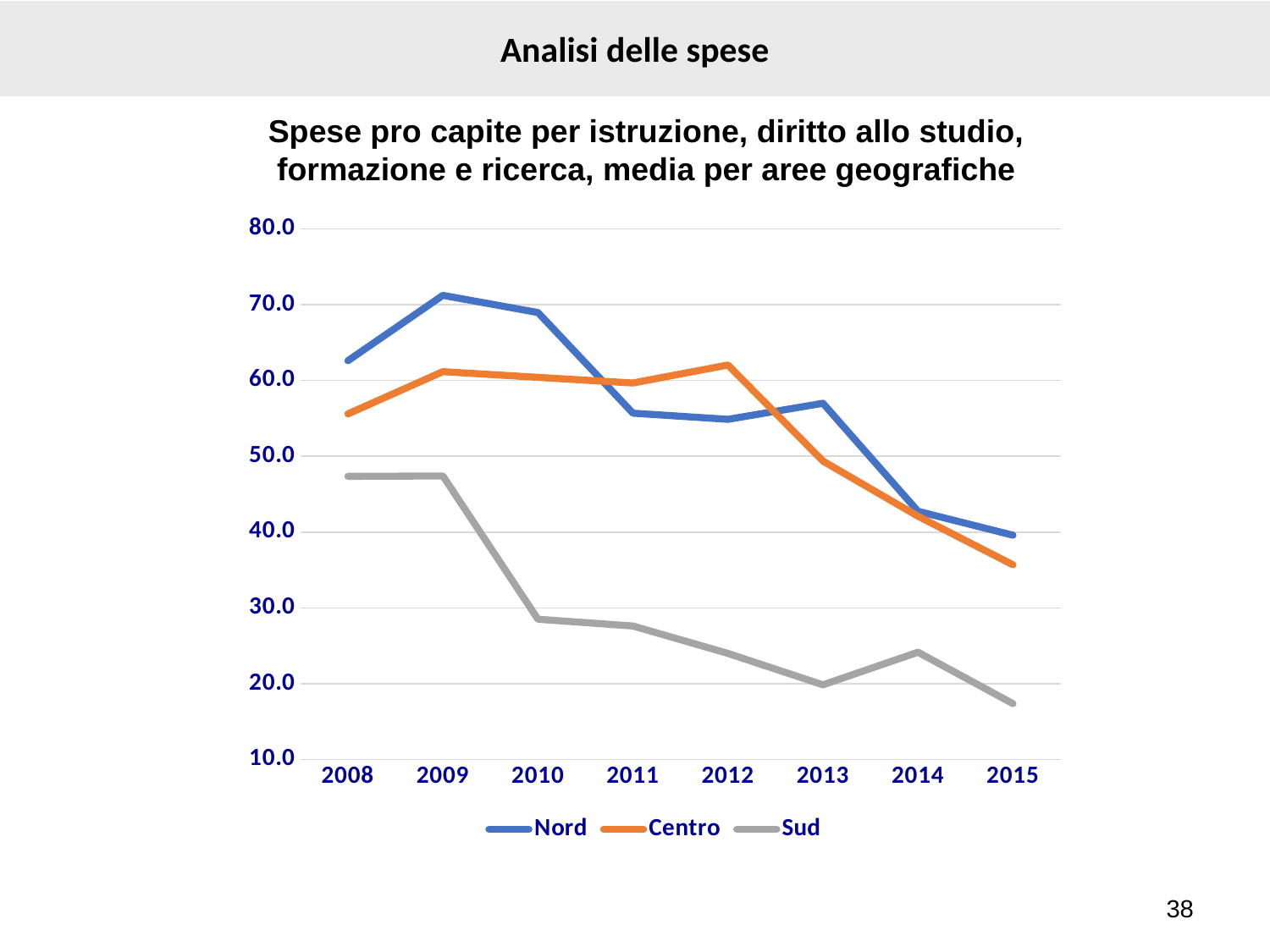
What kind of chart is shown on the slide? line chart In which year does the Nord series reach its highest value? 2009 Is the value for Nord in 2008 greater or less than 60.0? greater How many years are shown on the x axis? 8 In 2012, which series has the larger value, Nord or Centro? Centro How many series does the legend list? 3 Is the value for Sud in 2010 greater or less than 30.0? less Is the value for Centro in 2015 greater or less than 40.0? less In which year does the Sud series reach its lowest value? 2015 In 2008, which series has the larger value, Nord or Centro? Nord Does the Sud series rise or fall overall from 2008 to 2015? fall What are the three series named in the legend? Nord, Centro, Sud